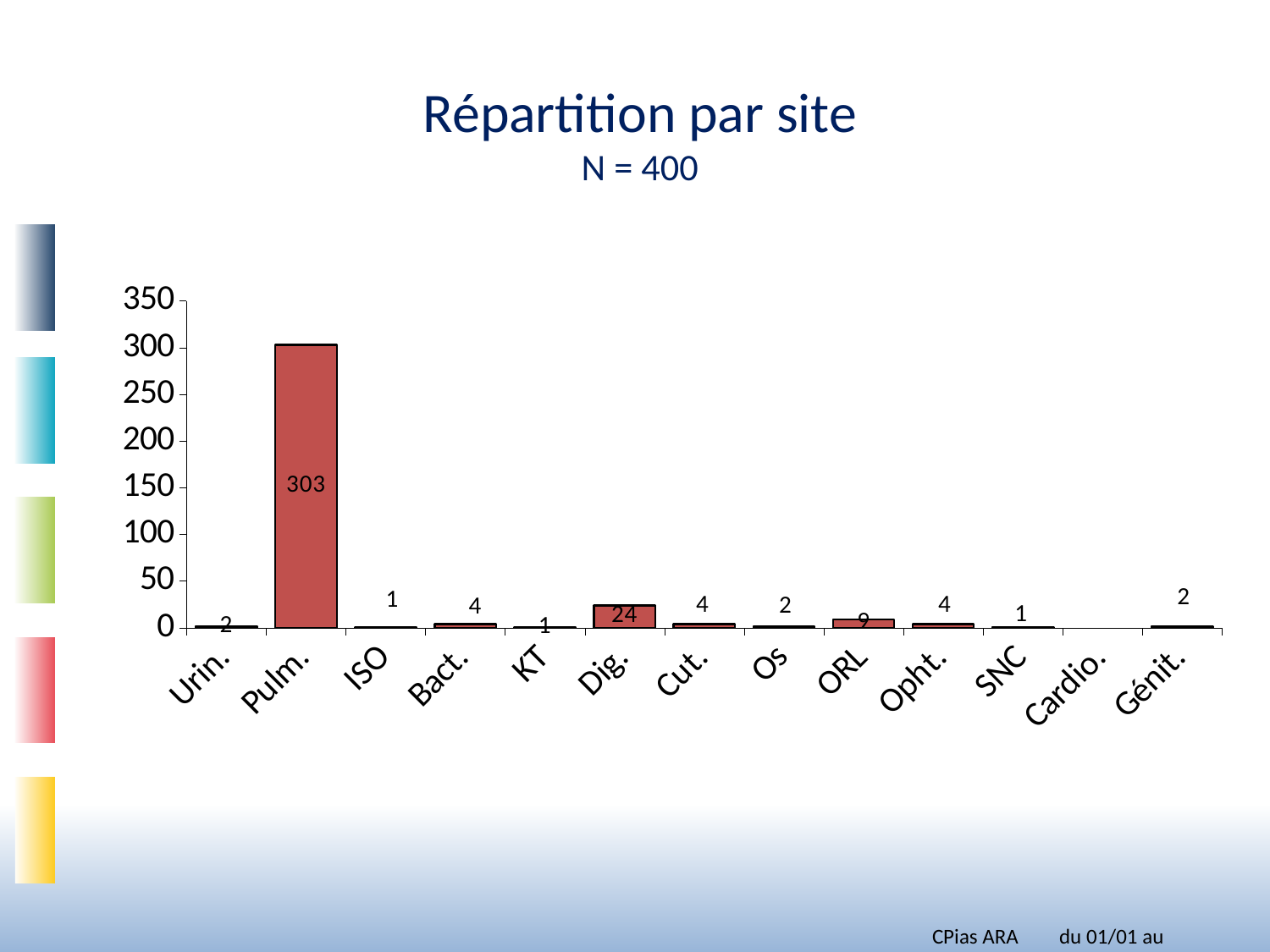
What is the difference between the values for Bact. and ISO? 3 What kind of chart is shown on the slide? bar chart What is the difference between the values for Pulm. and Dig.? 279 What is the title of the slide? Répartition par site Is the value for Pulm. greater or less than 250? greater How many categories are shown on the x axis? 13 Which is larger, the value for Dig. or the value for Cut.? Dig. What is the value for Urin.? 2 Which category has the highest value? Pulm. What is the value for Pulm.? 303 What is the value for Opht.? 4 What is the value for Dig.? 24